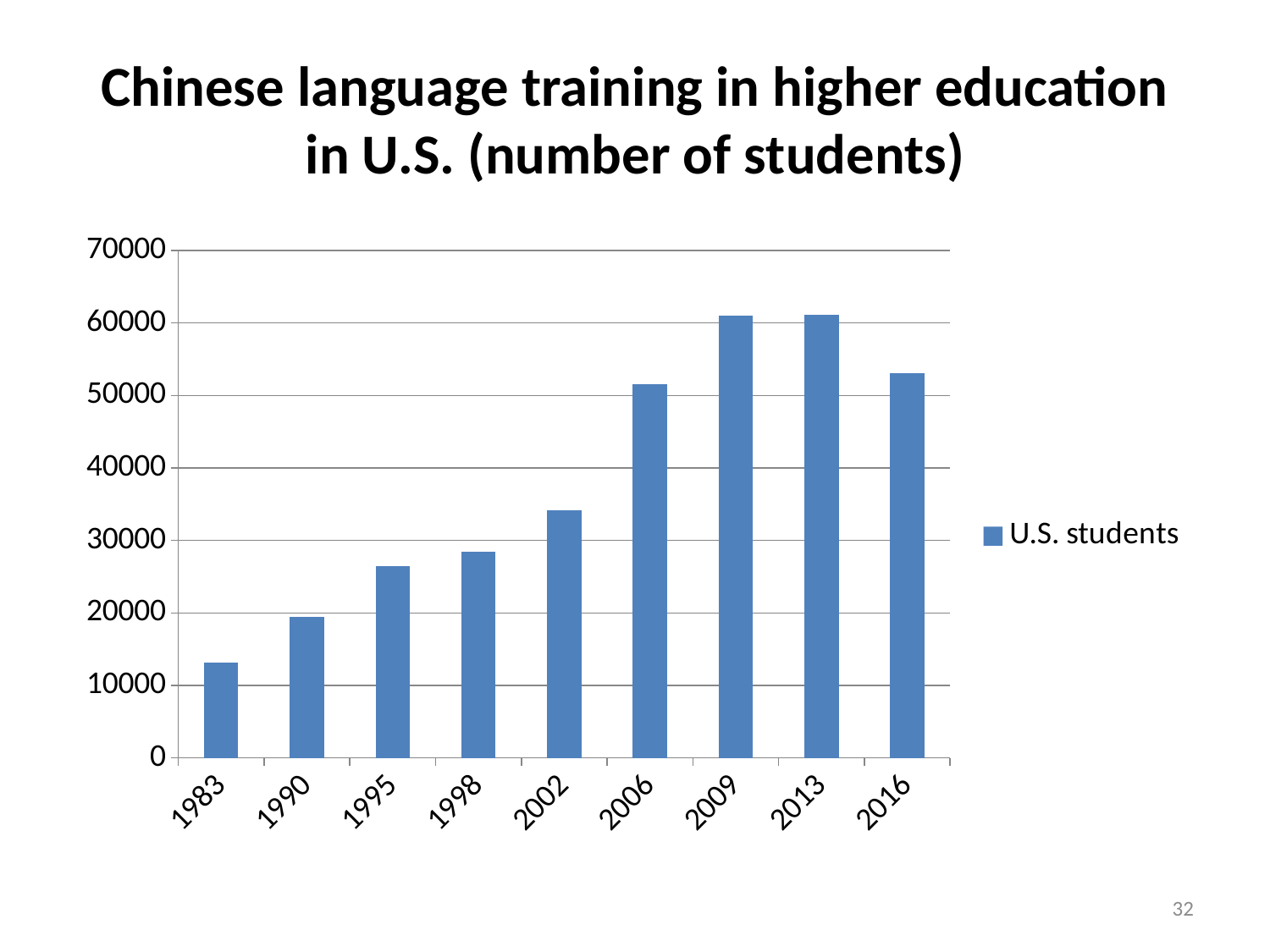
Which year has the lowest number of U.S. students? 1983 Is the value for 1983 greater or less than 20000? less Which year has the larger value, 1990 or 1995? 1995 How many years are shown on the x axis of the chart? 9 Is the value for 2002 greater or less than 40000? less How many series does the legend list? 1 Is the value for 2009 greater or less than 60000? greater Do the values rise or fall from 1983 to 2009? rise Which year has the larger value, 2002 or 2006? 2006 What is the name of the series shown in the legend? U.S. students What kind of chart is shown on the slide? bar chart